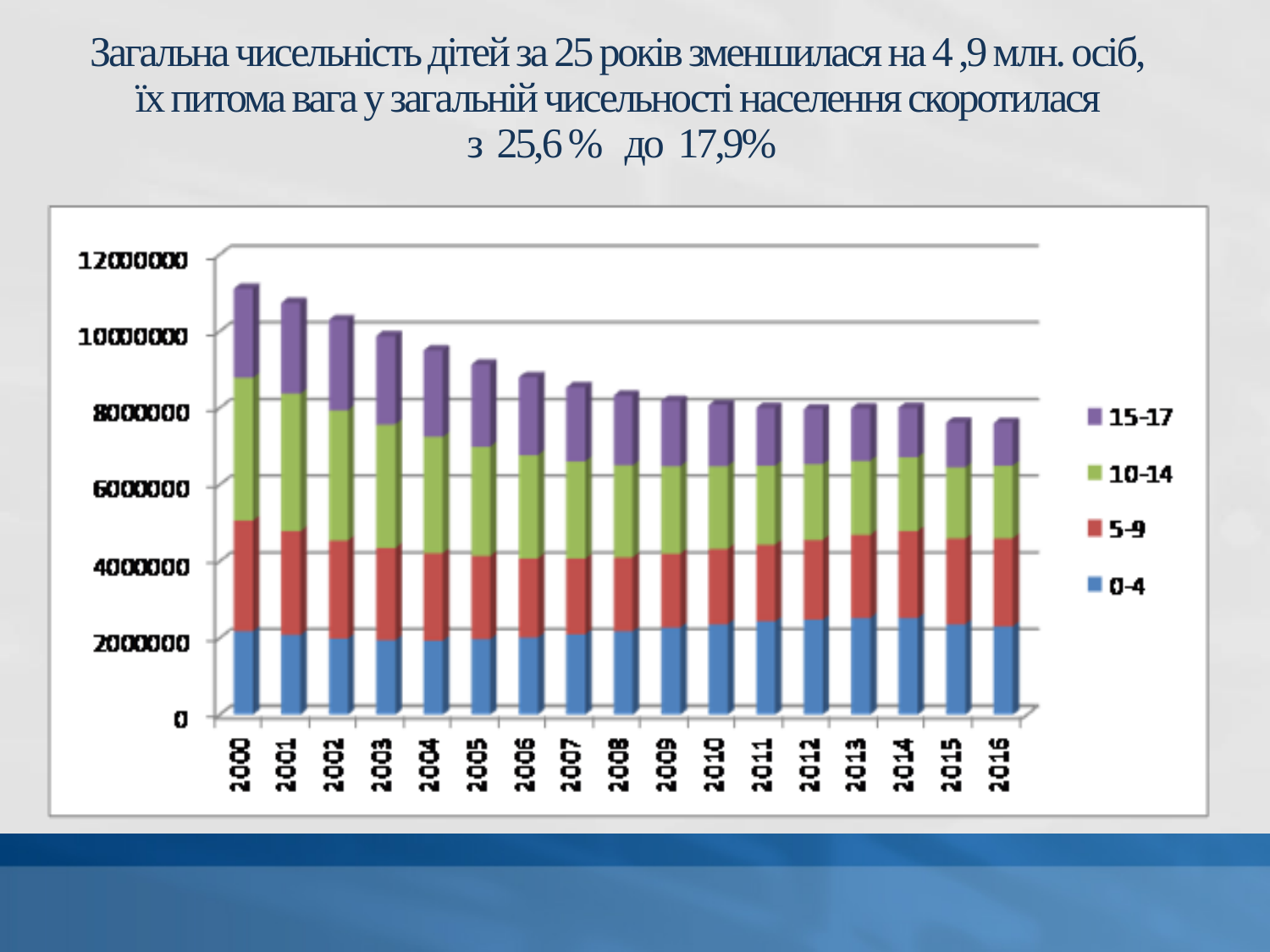
How many series does the chart's legend list? 4 What kind of chart is shown on the slide? Stacked bar chart Which year has the highest total bar in the chart? 2000 How many years are shown along the x axis of the chart? 17 Is the total bar for 2000 greater or less than 10000000? greater Do the total bar heights generally rise or fall from 2000 to 2016? Fall Is the total bar for 2005 greater or less than 8000000? greater Which age group is shown in blue at the bottom of each bar? 0-4 Which year has the larger total bar, 2000 or 2016? 2000 Which age groups are listed in the chart's legend? 15-17, 10-14, 5-9, 0-4 Which year has the larger total bar, 2001 or 2010? 2001 Is the total bar for 2016 greater or less than 8000000? less